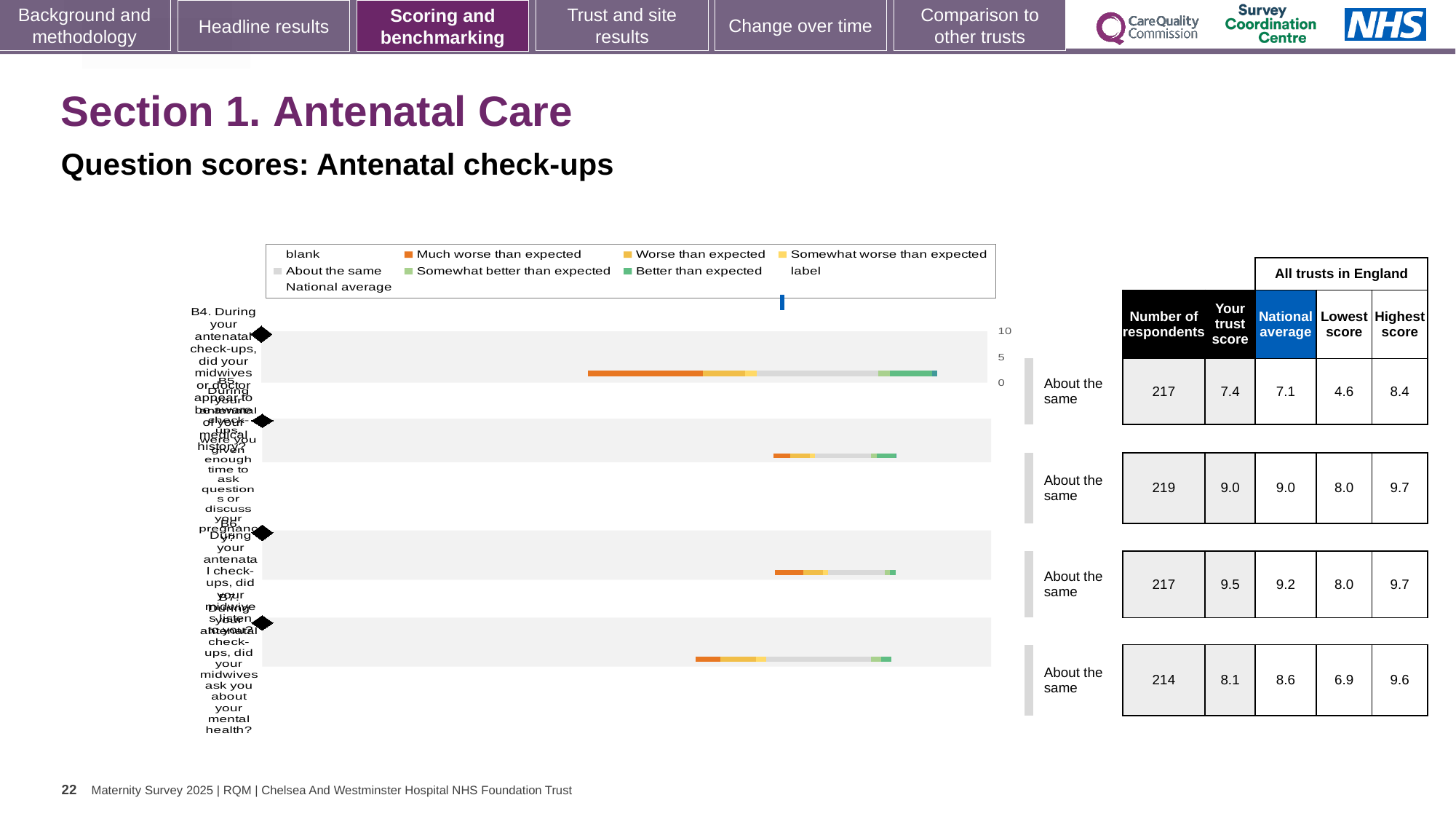
What is the highest score among all trusts in England for question B7 (midwives ask you about your mental health)? 9.6 For question B4, is the trust score or the national average higher? trust score How many respondents answered question B7 (midwives ask you about your mental health)? 214 What is the difference between the national average and the trust score for question B7 (midwives ask you about your mental health)? 0.5 What is the trust score for question B4 (midwives or doctor aware of your medical history)? 7.4 Which of the four questions has the lowest 'Lowest score' across all trusts in England? B4 (4.6) Which of the four questions has the highest trust score? the third question (9.5) What kind of chart is shown on the slide? bar chart How many questions (bars) are plotted in the chart? 4 What benchmark category is shown for question B4? About the same What is the national average for question B4 (midwives or doctor aware of your medical history)? 7.1 What is the title of the chart section on the slide? Question scores: Antenatal check-ups